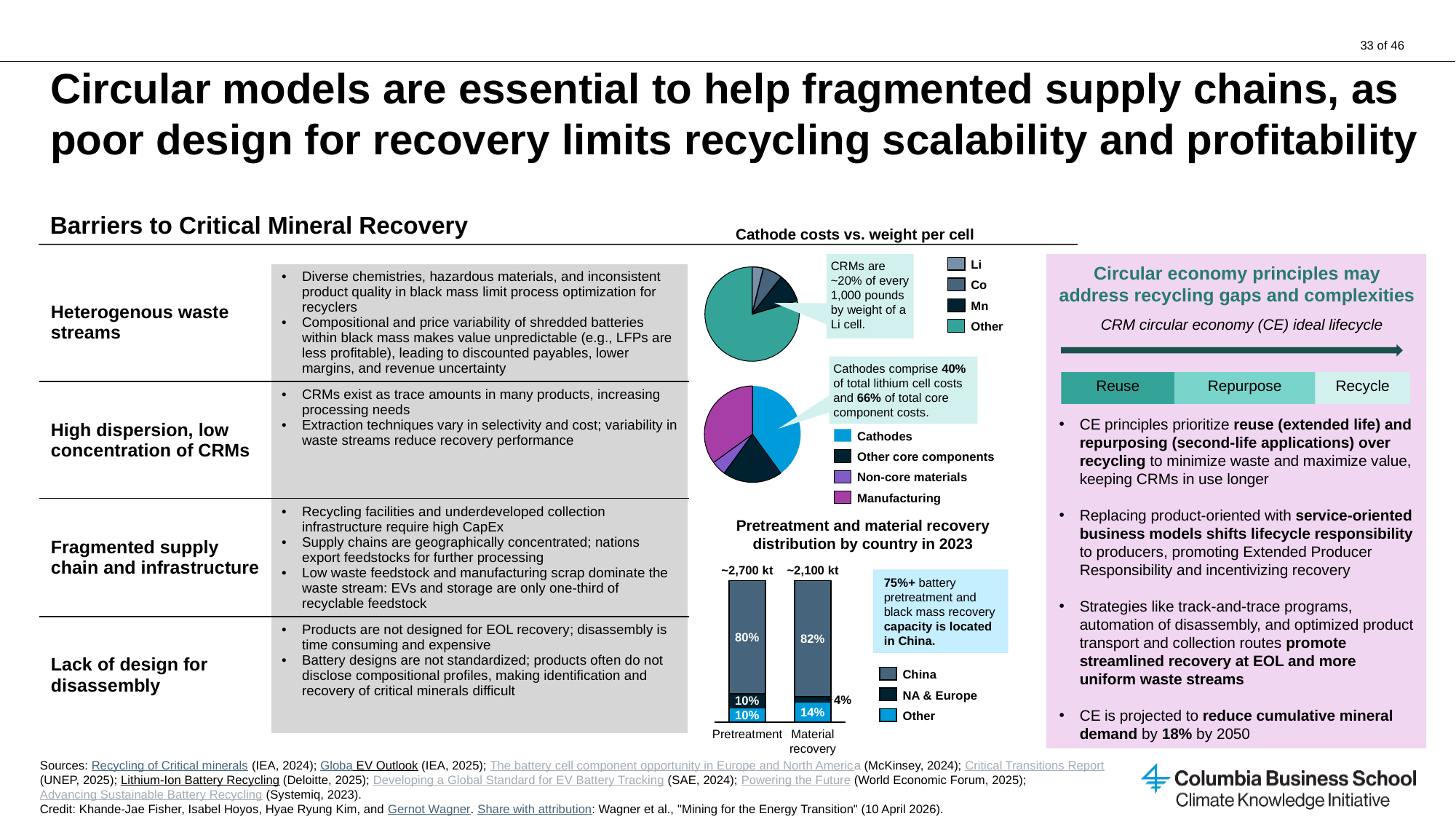
What kind of chart is the 'Pretreatment and material recovery distribution by country in 2023' chart? Stacked bar chart How many bars are shown in the 'Pretreatment and material recovery distribution by country in 2023' chart? 2 How many series does the legend of the 'Pretreatment and material recovery distribution by country in 2023' chart list? 3 In the 'Pretreatment and material recovery distribution by country in 2023' chart, is China's share larger in Pretreatment or in Material recovery? Material recovery In the 'Pretreatment and material recovery distribution by country in 2023' chart, what share does NA & Europe hold in Material recovery? 4% In the bottom pie chart under 'Cathode costs vs. weight per cell', which legend category has the smallest slice? Non-core materials In the 'Pretreatment and material recovery distribution by country in 2023' chart, what share does China hold in Material recovery? 82% How many categories does the legend of the bottom pie chart under 'Cathode costs vs. weight per cell' list? 4 In the 'Pretreatment and material recovery distribution by country in 2023' chart, what is the difference between NA & Europe's share in Pretreatment and in Material recovery? 6 percentage points In the top pie chart under 'Cathode costs vs. weight per cell', which legend category has the largest slice? Other In the 'Pretreatment and material recovery distribution by country in 2023' chart, what share does 'Other' hold in Material recovery? 14% In the 'Pretreatment and material recovery distribution by country in 2023' chart, what share does China hold in Pretreatment? 80%